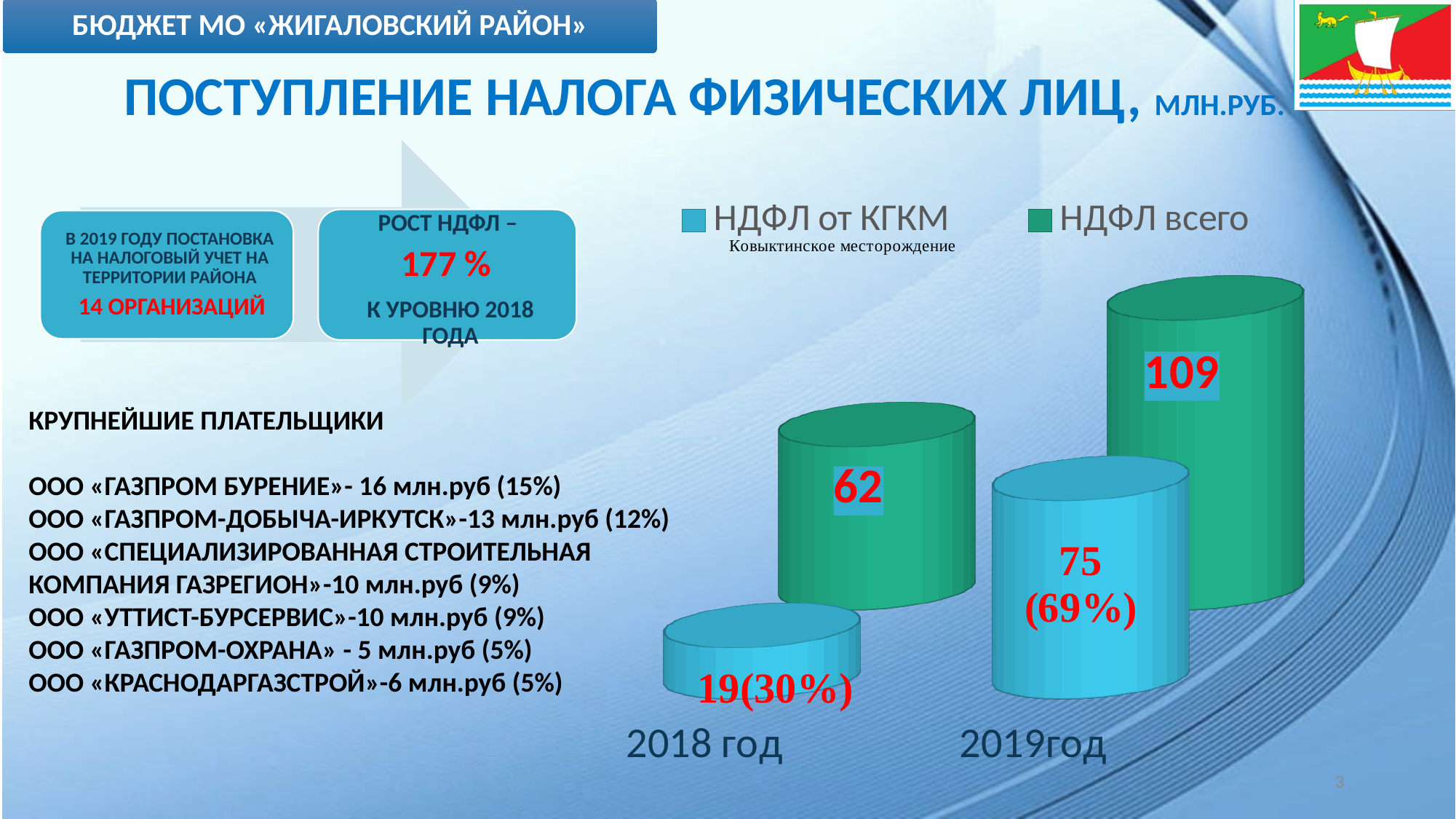
What is the data label on the НДФЛ от КГКМ bar for 2019год? 75 (69%) What is the value for НДФЛ всего in 2018 год? 62 Which year has the higher value for НДФЛ всего? 2019год Do the values for НДФЛ от КГКМ rise or fall from 2018 год to 2019год? rise What is the difference between НДФЛ всего and НДФЛ от КГКМ in 2019год? 34 Is НДФЛ от КГКМ in 2019год larger or smaller than НДФЛ всего in 2018 год? larger What is the data label on the НДФЛ от КГКМ bar for 2018 год? 19(30%) By how much did НДФЛ всего increase from 2018 год to 2019год? 47 How many categories are shown on the x axis of the chart? 2 How many series does the chart legend list? 2 Which year has the lower value for НДФЛ от КГКМ? 2018 год What is the value for НДФЛ всего in 2019год? 109